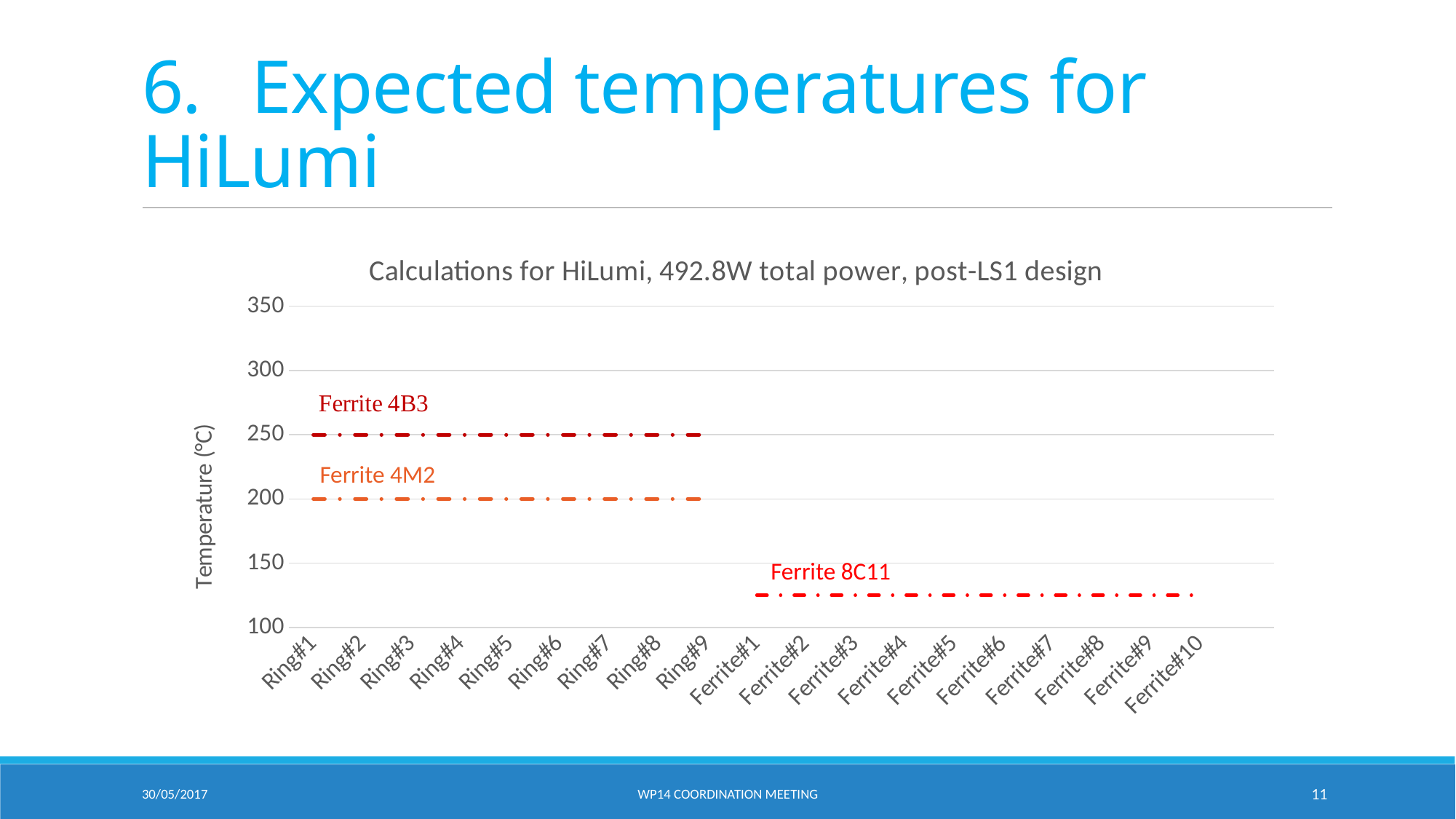
At what temperature does the Ferrite 4M2 line sit? 200 Is the temperature for Ferrite 8C11 greater or less than 150? less What is the difference in temperature between the Ferrite 4B3 line and the Ferrite 4M2 line? 50 How many Ring categories are on the x axis? 9 Which of the three ferrite lines is at the lowest temperature? Ferrite 8C11 Which of the three ferrite lines is at the highest temperature? Ferrite 4B3 What kind of chart is shown on the slide? line chart At what temperature does the Ferrite 4B3 line sit? 250 How many categories are listed along the x axis? 19 Does the Ferrite 8C11 line rise, fall or stay flat from Ferrite#1 to Ferrite#10? stays flat What is the label of the vertical axis? Temperature (°C) What is the title of the chart? Calculations for HiLumi, 492.8W total power, post-LS1 design